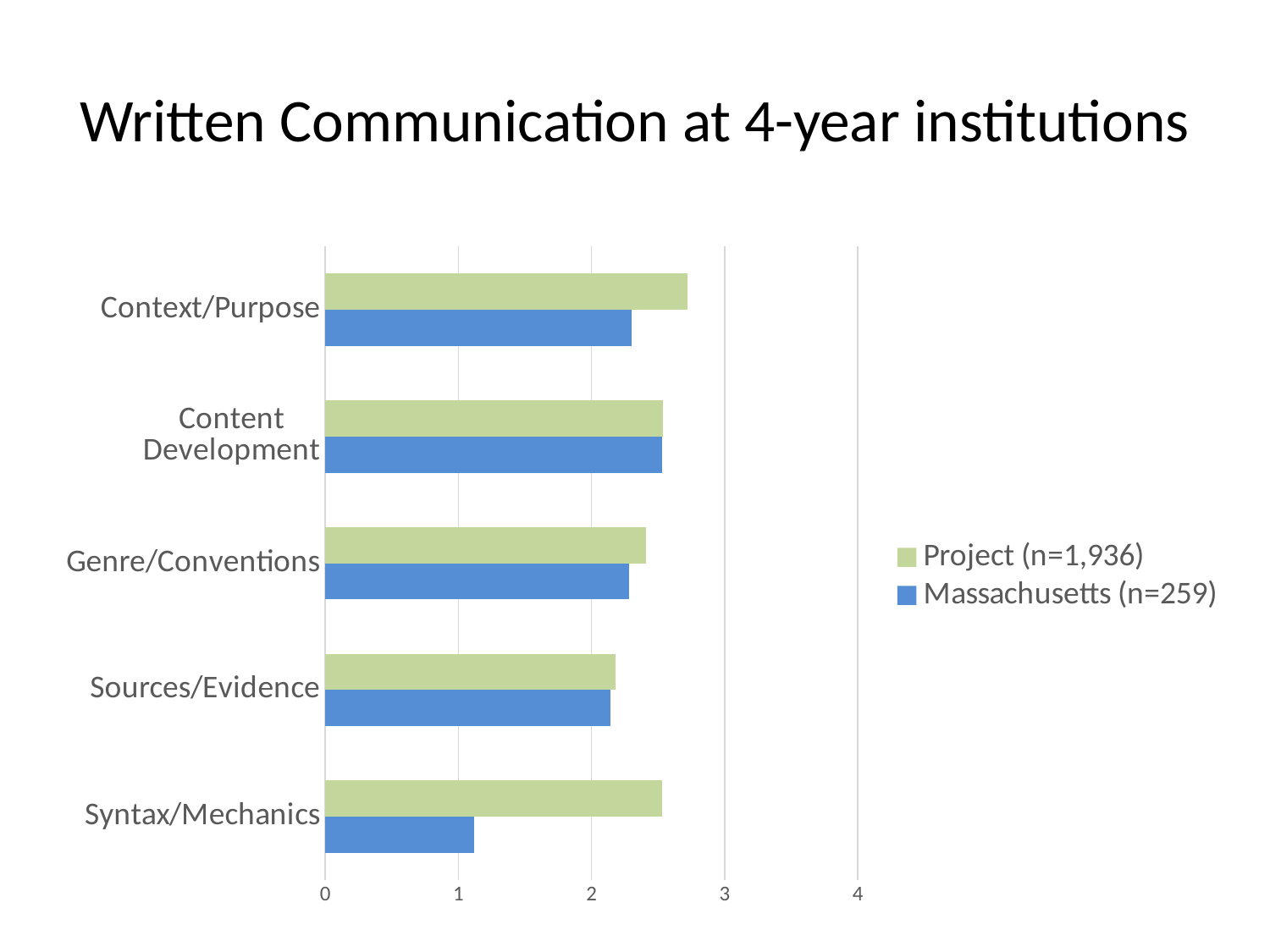
Is the Project (n=1,936) value for Context/Purpose greater or less than 3? less Which category has the lowest Massachusetts (n=259) value? Syntax/Mechanics For Syntax/Mechanics, which series has the larger value, Project (n=1,936) or Massachusetts (n=259)? Project (n=1,936) Is the Project (n=1,936) value for Sources/Evidence greater or less than 2? greater What kind of chart is shown on the slide? bar chart How many series does the legend list? 2 How many categories are shown on the chart? 5 Is the Massachusetts (n=259) value for Syntax/Mechanics greater or less than 2? less Which series is shown in blue? Massachusetts (n=259) What is the title of the chart? Written Communication at 4-year institutions Which category has the highest Project (n=1,936) value? Context/Purpose